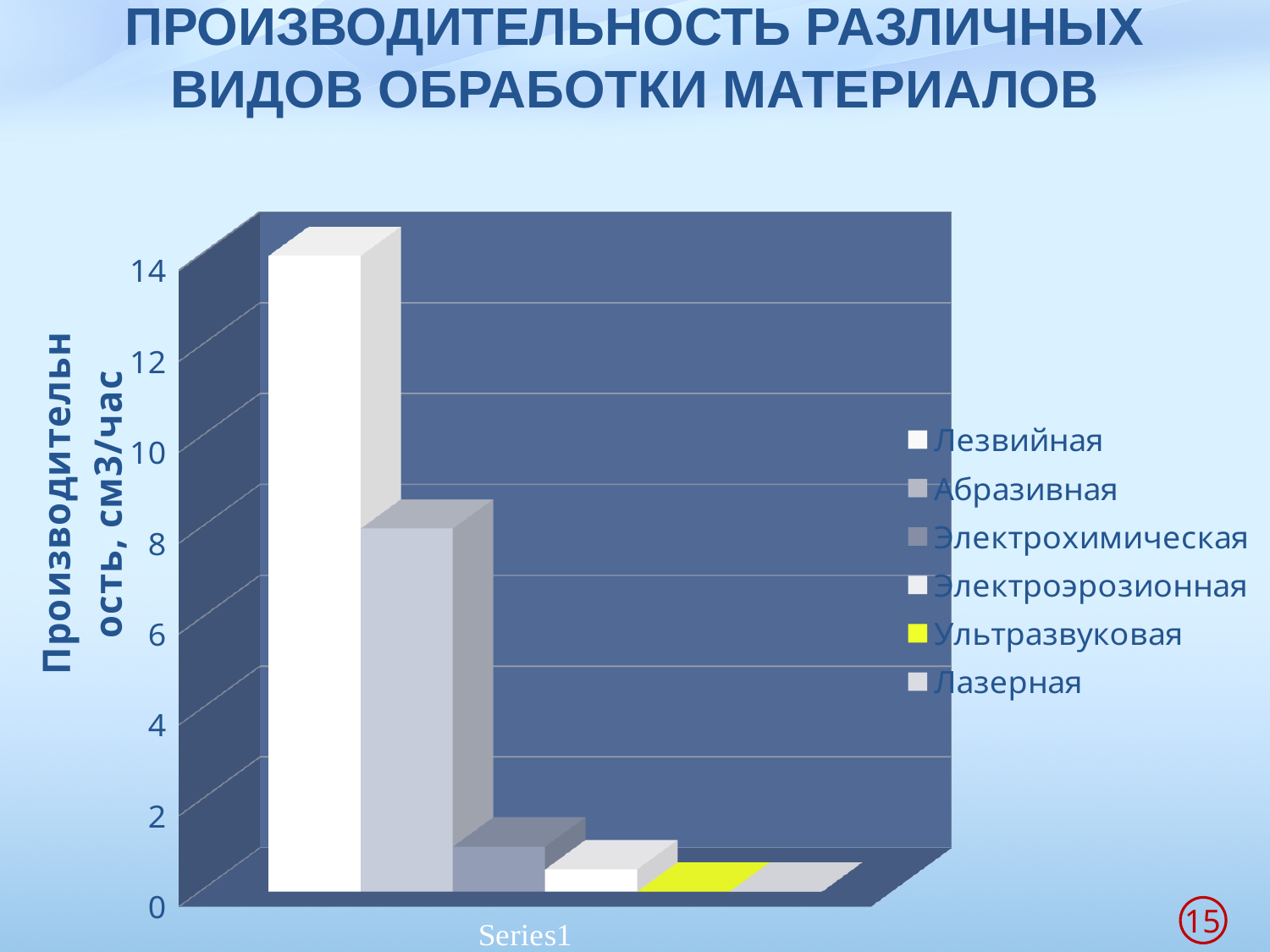
Is the value for Лезвийная greater or less than 12? greater Which is larger, the value for Абразивная or the value for Электрохимическая? Абразивная What kind of chart is shown on the slide? bar chart Which series is shown in yellow in the legend? Ультразвуковая Which is larger, the value for Лезвийная or the value for Абразивная? Лезвийная Is the value for Электрохимическая greater or less than 4? less How many series does the legend list? 6 Which processing type has the highest productivity in the chart? Лезвийная What is the label of the vertical axis? Производительность, см3/час Is the value for Электроэрозионная greater or less than 2? less